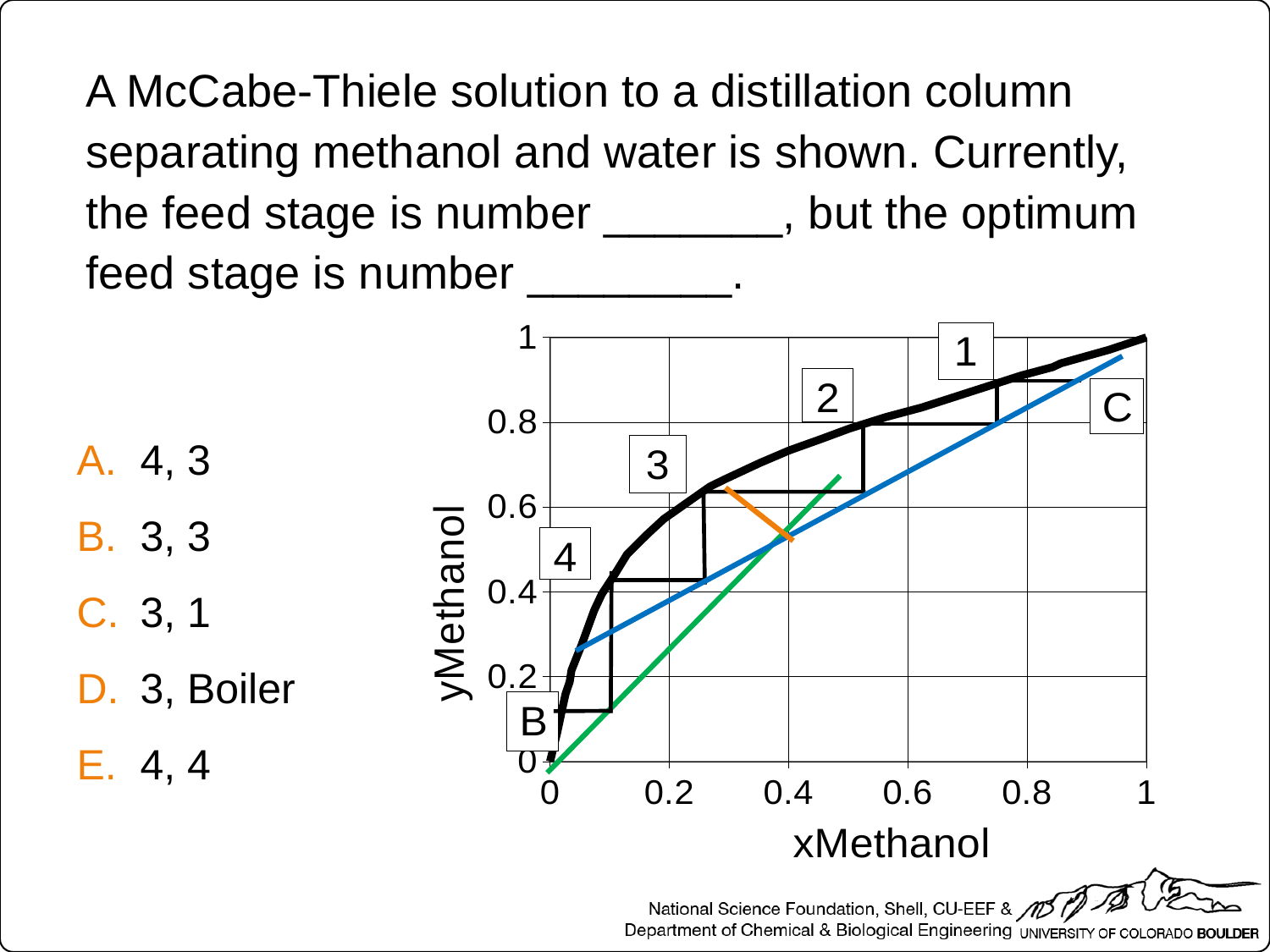
What is the highest value shown on the x axis of the chart? 1 Is the value of the thick black equilibrium curve at xMethanol = 0.2 greater or less than 0.4? greater What kind of chart is shown on the slide? line chart Is the value of the blue line at xMethanol = 0.4 greater or less than 0.6? less What is the label of the y axis of the chart? yMethanol What is the label of the x axis of the chart? xMethanol How many numbered stages are labelled on the chart? 4 What is the lowest value shown on the y axis of the chart? 0 Does the thick black equilibrium curve rise or fall as xMethanol increases? rise Is the value of the thick black equilibrium curve at xMethanol = 0.4 greater or less than 0.6? greater Which stage number is labelled closest to the top-right corner of the chart? 1 How many tick labels are shown on the x axis of the chart? 6